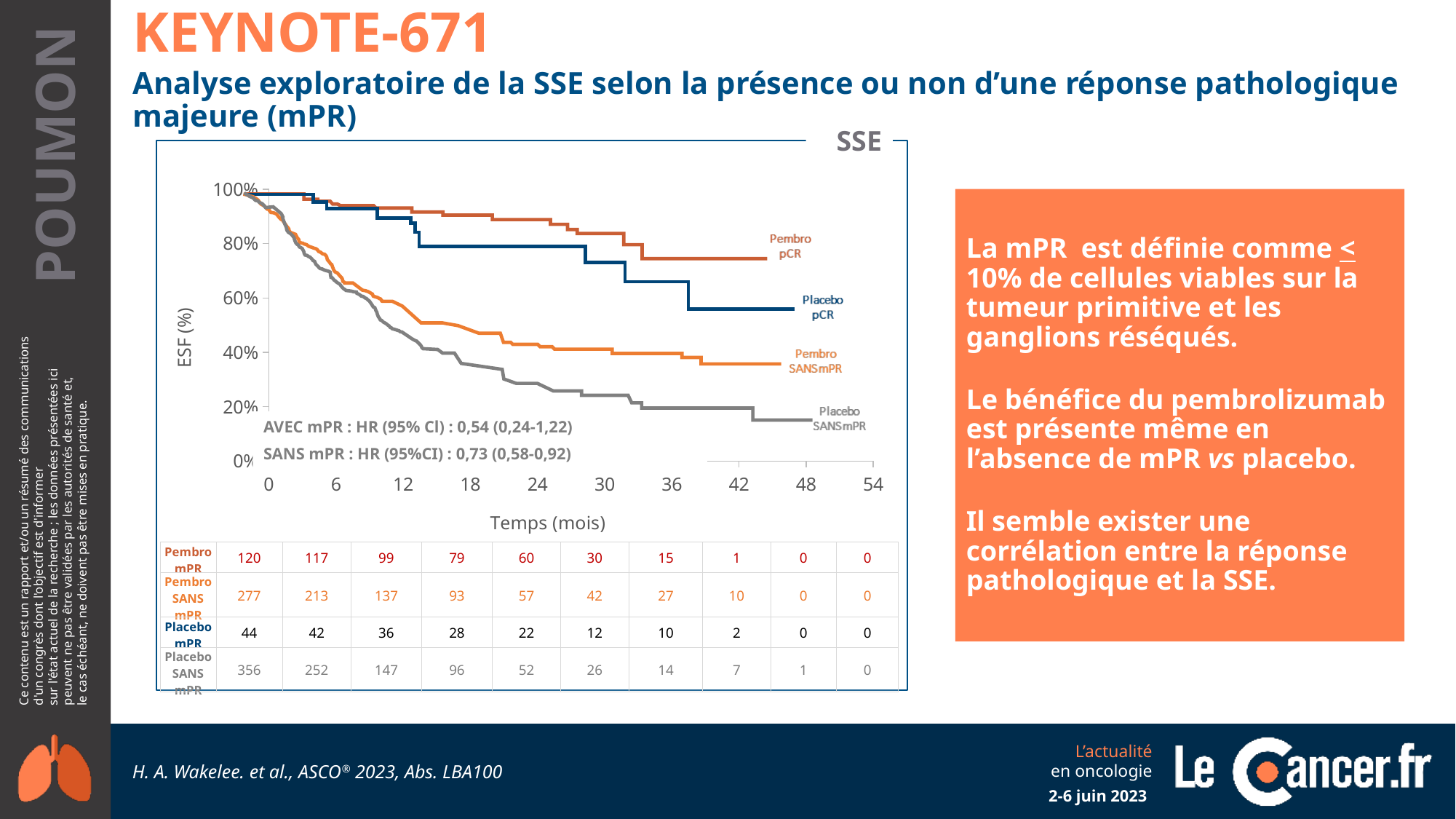
What is the label of the x axis of the SSE chart? Temps (mois) What kind of chart is shown on the slide? line chart In the number-at-risk table at 18 months, which group has more patients: Pembro SANS mPR or Placebo SANS mPR? Placebo SANS mPR Is the value of the Placebo SANS mPR curve at 24 months greater or less than 40%? less What is the hazard ratio reported for the AVEC mPR comparison? 0,54 (0,24-1,22) Which curve is the highest at 36 months on the SSE chart? Pembro pCR In the number-at-risk table, how many patients are in the Placebo SANS mPR group at 12 months? 147 What is the label of the y axis of the SSE chart? ESF (%) In the number-at-risk table, how many patients are in the Pembro mPR group at 0 months? 120 In the number-at-risk table, what is the difference between the Pembro SANS mPR group and the Placebo mPR group at 0 months? 233 How many curves are plotted on the SSE chart? 4 Is the value of the Pembro pCR curve at 36 months greater or less than 60%? greater